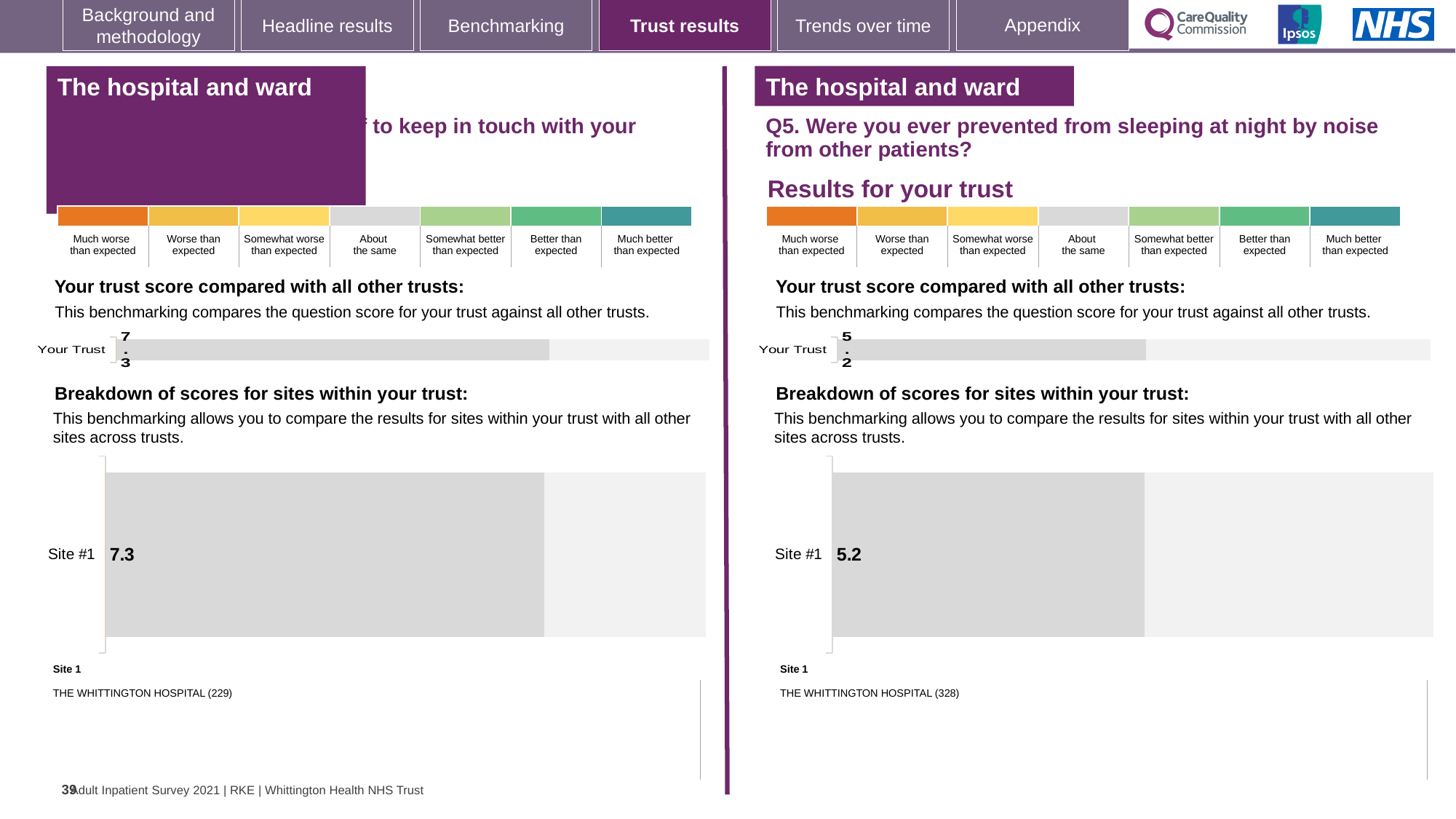
What type of chart is used to show the Site #1 score on the right-hand panel (Q5)? Bar chart What is the difference between the Site #1 score on the left-hand panel (7.3) and the Site #1 score on the right-hand panel (5.2)? 2.1 Is the 'Your Trust' score on the right-hand panel (Q5) greater or less than the 'Your Trust' score on the left-hand panel? less On the right-hand panel (Q5), which site name is listed as Site 1 below the chart? THE WHITTINGTON HOSPITAL (328) How many sites are shown in the 'Breakdown of scores for sites within your trust' chart on the right-hand panel (Q5)? 1 Which is larger: the Site #1 score on the left-hand panel or the Site #1 score on the right-hand panel (Q5)? Left-hand panel (7.3) On the left-hand panel, what score is shown for Site #1 in the 'Breakdown of scores for sites within your trust' chart? 7.3 On the right-hand panel (Q5), what is the score shown for 'Your Trust' in the 'Your trust score compared with all other trusts' chart? 5.2 On the left-hand panel, what is the score shown for 'Your Trust' in the 'Your trust score compared with all other trusts' chart? 7.3 How many sites are shown in the 'Breakdown of scores for sites within your trust' chart on the left-hand panel? 1 On the left-hand panel, which site name is listed as Site 1 below the chart? THE WHITTINGTON HOSPITAL (229) On the right-hand panel (Q5), what score is shown for Site #1 in the 'Breakdown of scores for sites within your trust' chart? 5.2